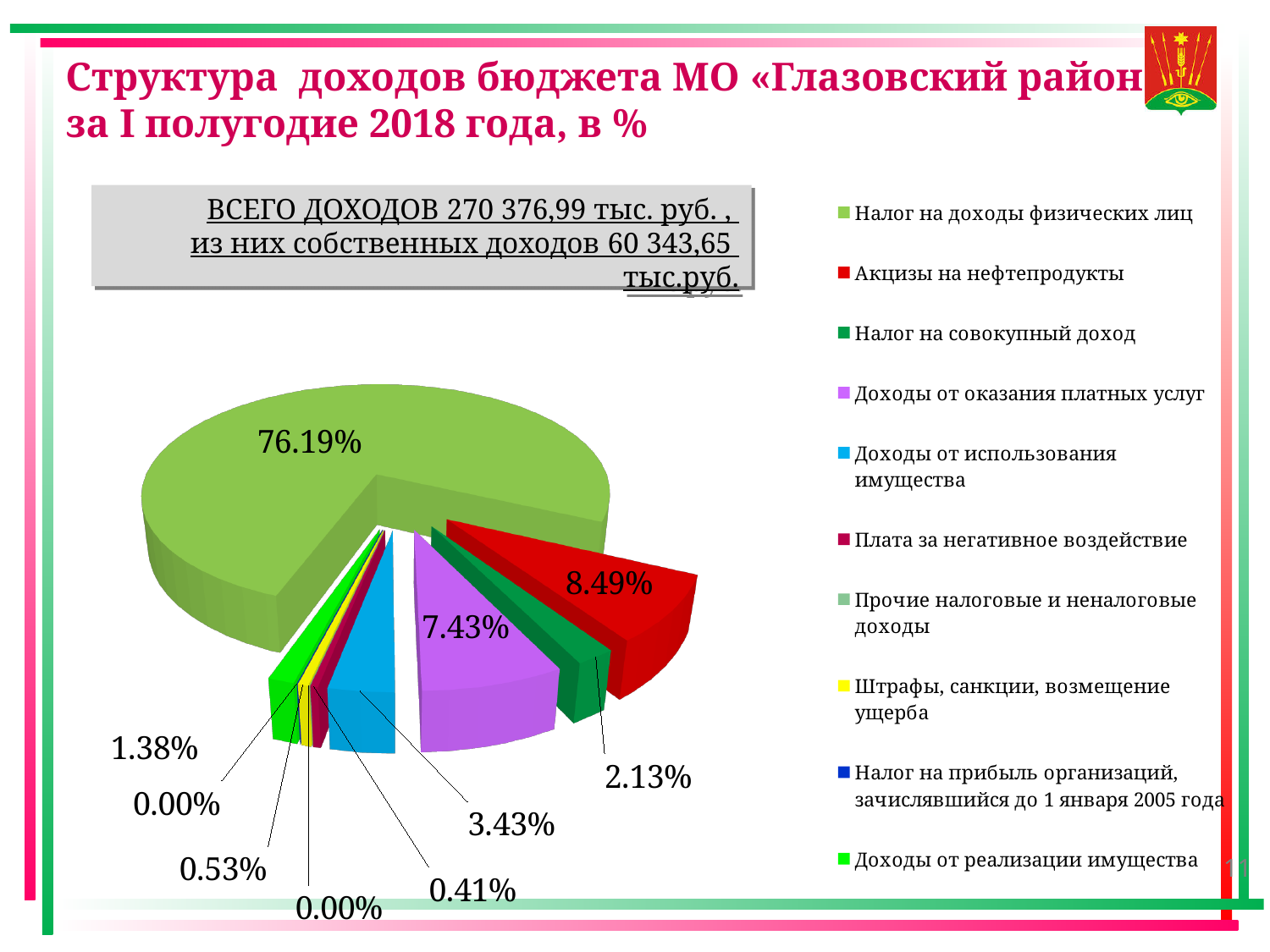
What share of the pie does "Доходы от использования имущества" have? 3.43% What colour is the slice for "Акцизы на нефтепродукты"? red What share of the pie does "Акцизы на нефтепродукты" have? 8.49% What kind of chart is shown on the slide? pie chart Which is larger: the slice for "Акцизы на нефтепродукты" or the slice for "Доходы от оказания платных услуг"? Акцизы на нефтепродукты What is the difference in percentage points between the "Налог на доходы физических лиц" slice and the "Акцизы на нефтепродукты" slice? 67.70 What share of the pie does "Доходы от оказания платных услуг" have? 7.43% Which category has the largest slice of the pie? Налог на доходы физических лиц What share of the pie does "Налог на совокупный доход" have? 2.13% What share of the pie does "Налог на доходы физических лиц" have? 76.19% What share of the pie does "Доходы от реализации имущества" have? 1.38% How many entries does the legend of the pie chart list? 10